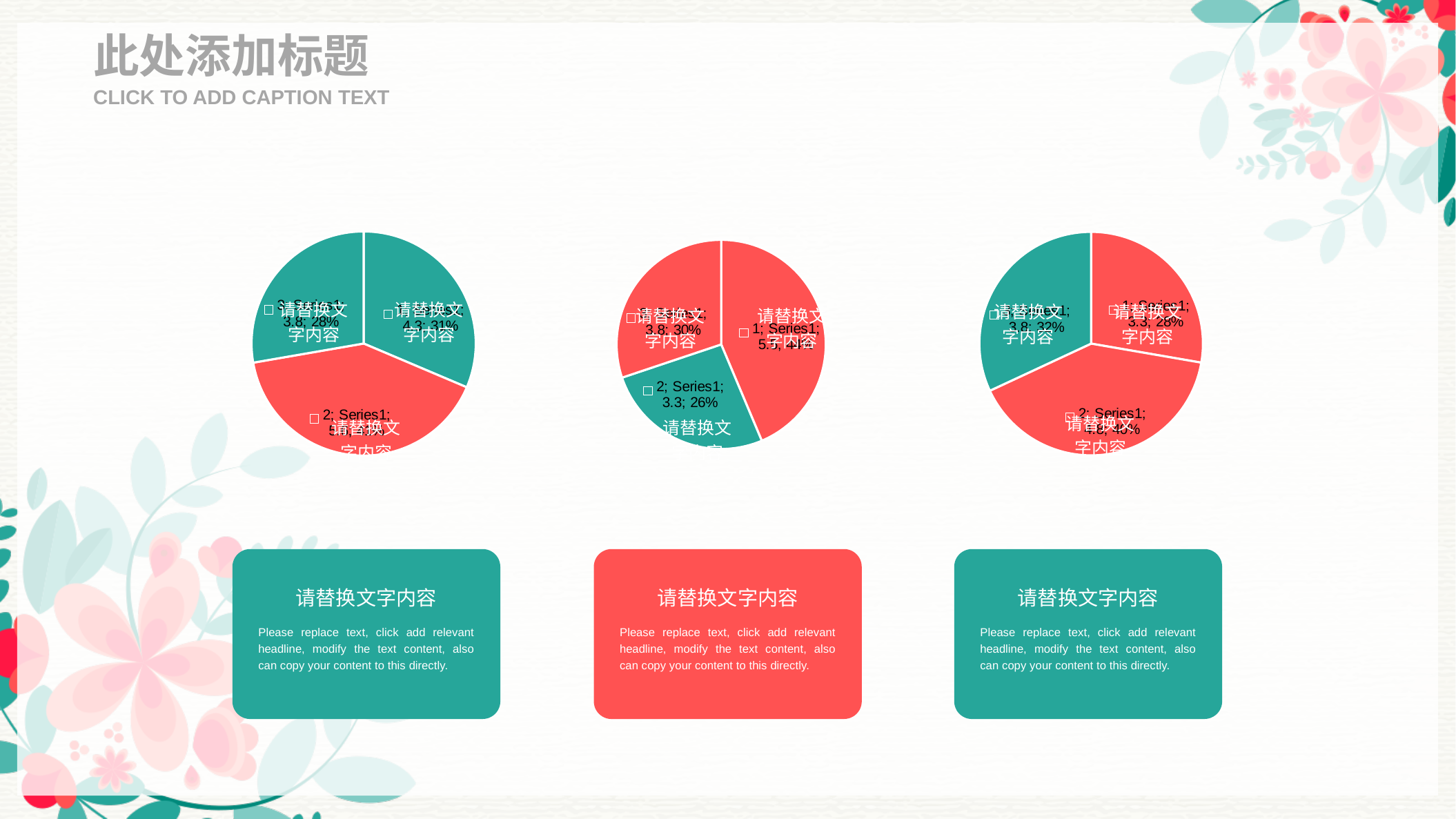
In the left pie chart, which category has the largest slice? 2 In the left pie chart, what share of the pie does category 3 represent? 28% In the left pie chart, what is the value for category 1? 4.3 In the middle pie chart, what share of the pie does the teal slice (category 2) represent? 26% In the right pie chart, what share of the pie does category 3 (the teal slice) represent? 32% In the middle pie chart, which category has the smallest slice? 2 In the right pie chart, what is the value for category 1? 3.3 How many slices does the middle pie chart have? 3 In the right pie chart, which is larger, the slice for category 3 or the slice for category 1? category 3 What kind of chart is the left chart on the slide? pie chart In the middle pie chart, what is the value for category 2 (the teal slice)? 3.3